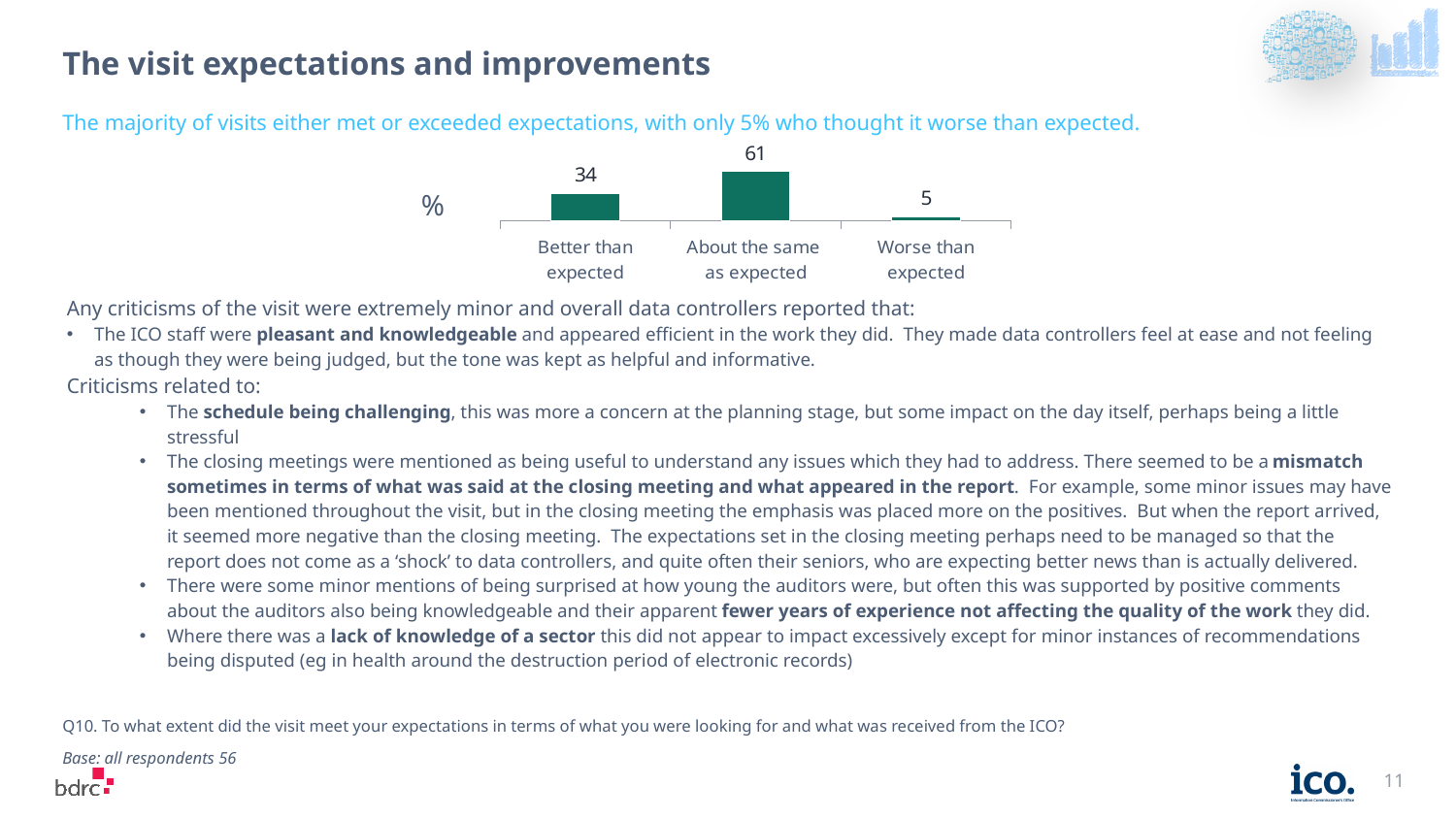
What is the value for 'Better than expected'? 34 What is the difference between the values for 'Better than expected' and 'Worse than expected'? 29 What kind of chart is shown on the slide? Bar chart What is the value for 'Worse than expected'? 5 What is the total of the three values shown in the chart? 100 Which is larger, the value for 'Better than expected' or 'Worse than expected'? Better than expected Which category has the lowest value? Worse than expected What is the difference between the values for 'About the same as expected' and 'Better than expected'? 27 What is the value for 'About the same as expected'? 61 How many categories are shown in the chart? 3 Which category has the highest value? About the same as expected What unit label is shown to the left of the chart? %